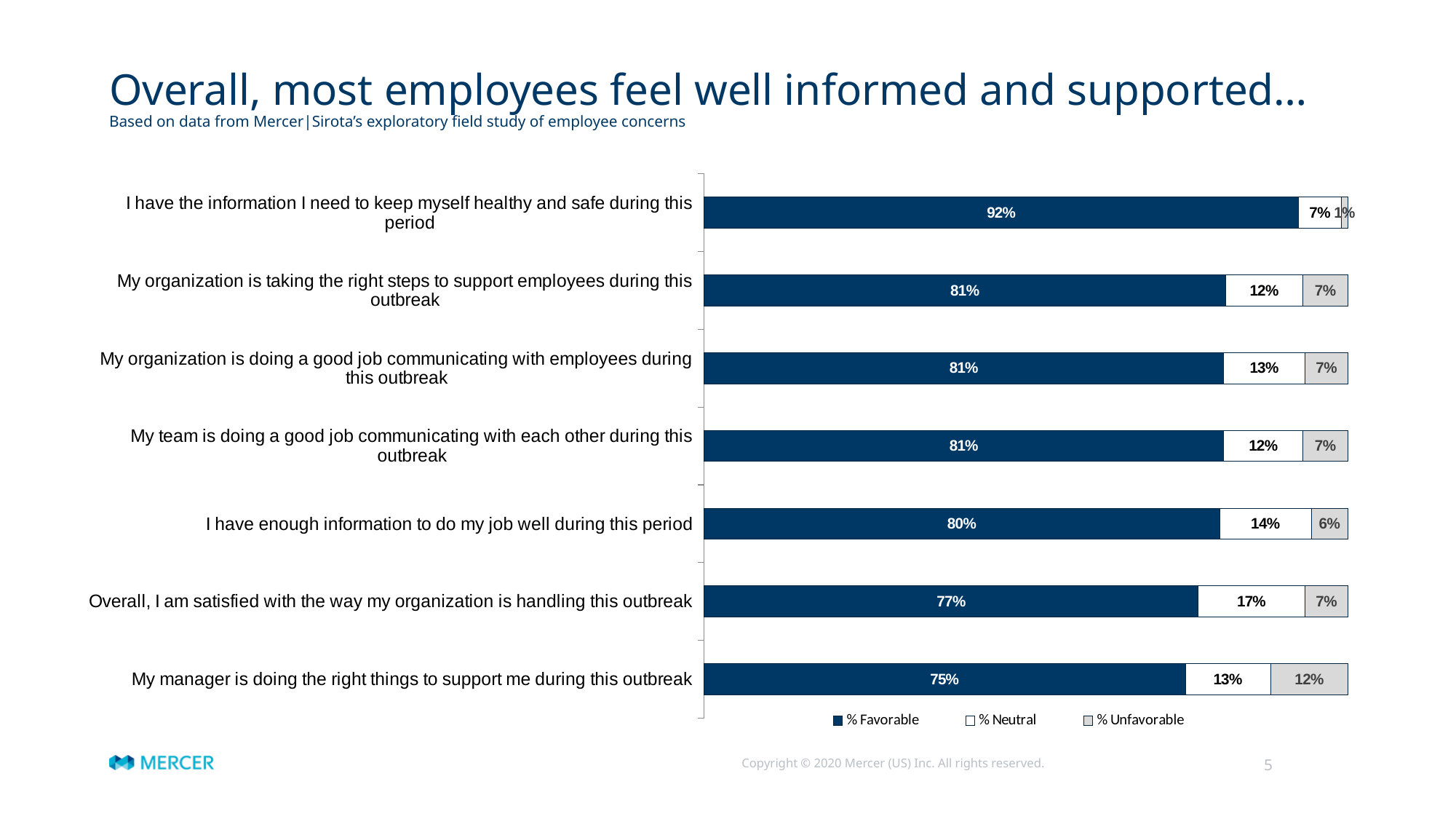
What is the % Neutral value for "I have enough information to do my job well during this period"? 14% Which statement has the highest % Favorable value? I have the information I need to keep myself healthy and safe during this period Which statement has the highest % Unfavorable value? My manager is doing the right things to support me during this outbreak Which has a larger % Neutral value: "Overall, I am satisfied with the way my organization is handling this outbreak" or "My team is doing a good job communicating with each other during this outbreak"? Overall, I am satisfied with the way my organization is handling this outbreak Which statement has the lowest % Favorable value? My manager is doing the right things to support me during this outbreak What is the % Favorable value for "I have the information I need to keep myself healthy and safe during this period"? 92% What is the % Unfavorable value for "My manager is doing the right things to support me during this outbreak"? 12% What is the % Neutral value for "Overall, I am satisfied with the way my organization is handling this outbreak"? 17% What is the difference in % Favorable between "I have the information I need to keep myself healthy and safe during this period" and "My manager is doing the right things to support me during this outbreak"? 17 percentage points How many series does the legend list? 3 How many statements are shown in the chart? 7 What kind of chart is shown on the slide? Stacked bar chart